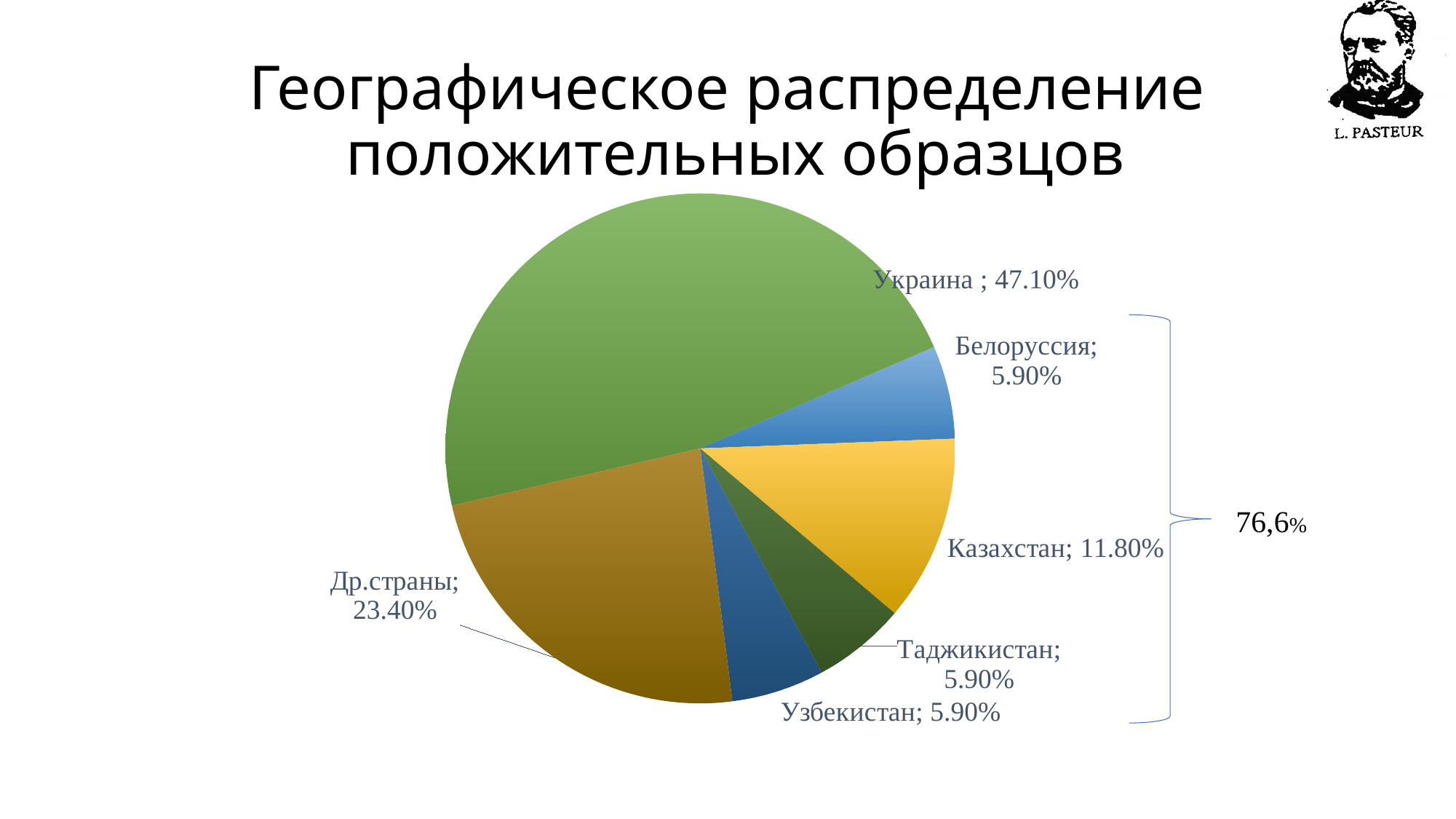
What value is written next to the bracket on the right side of the chart? 76,6% What is the difference between the values for Др.страны and Казахстан? 11.60% What is the value shown for Белоруссия? 5.90% What is the value shown for Украина? 47.10% What is the difference between the values for Украина and Др.страны? 23.70% What is the value shown for Казахстан? 11.80% What type of chart is shown on the slide? pie chart What share of the pie does Узбекистан account for? 5.90% How many slices does the pie chart have? 6 What is the value shown for Др.страны? 23.40% Which is larger, the value for Казахстан or the value for Таджикистан? Казахстан Which category has the largest slice of the pie? Украина